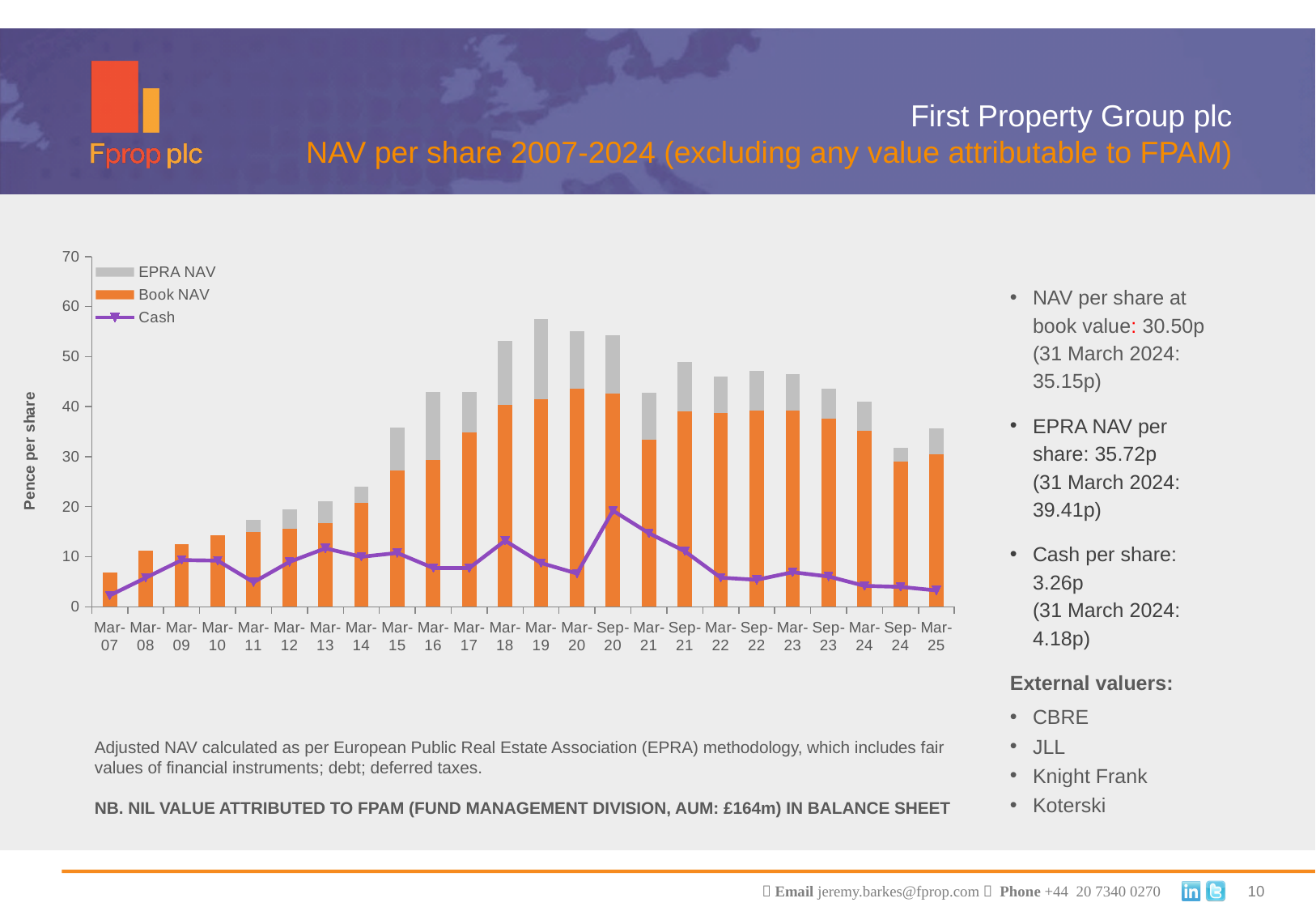
Which period has the tallest stacked bar (highest EPRA NAV) in the chart? Mar-19 Is the total stacked bar for Mar-19 greater or less than 50? greater In which period does the Cash line reach its highest point? Sep-20 How many series does the chart legend list? 3 Is the total stacked bar for Mar-07 greater or less than 10? less Is the total stacked bar for Sep-24 greater or less than 40? less Do the stacked bars generally rise or fall from Mar-07 to Mar-19? rise Which has the taller stacked bar, Mar-19 or Mar-25? Mar-19 Which period has the shortest stacked bar in the chart? Mar-07 How many time periods are shown along the x axis of the chart? 24 What kind of chart is shown on the slide? Stacked bar chart with a line